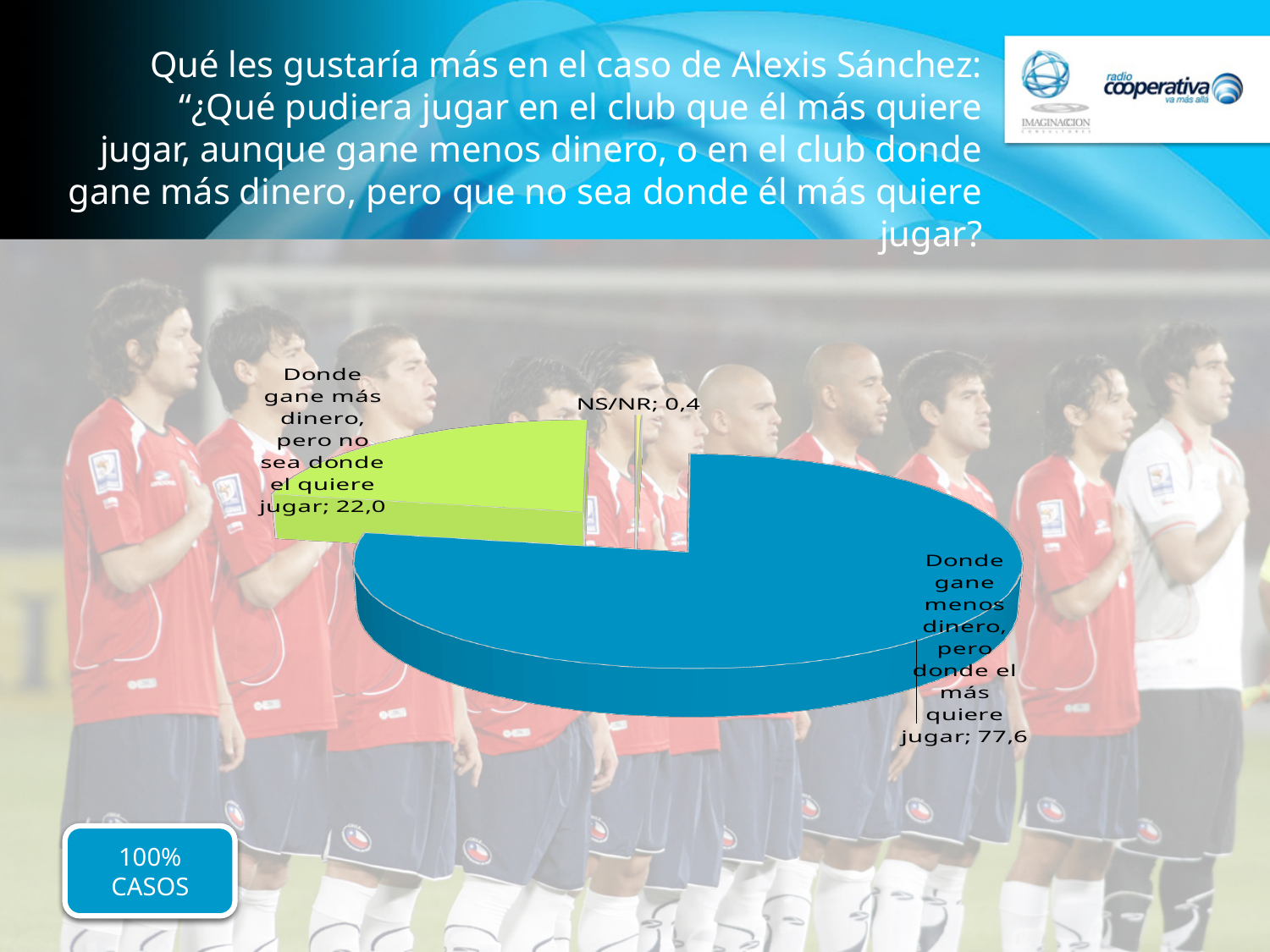
What colour is the slice for "Donde gane más dinero, pero no sea donde el quiere jugar"? green What is the combined value of the two named club options (excluding NS/NR)? 99,6 What kind of chart is shown on the slide? pie chart How many slices does the pie chart have? 3 Which slice of the pie chart is the smallest? NS/NR What is the difference between the value for "Donde gane menos dinero, pero donde el más quiere jugar" and the value for "Donde gane más dinero, pero no sea donde el quiere jugar"? 55,6 What is the value for "Donde gane más dinero, pero no sea donde el quiere jugar"? 22,0 What colour is the largest slice of the pie chart? blue Which slice of the pie chart is the largest? Donde gane menos dinero, pero donde el más quiere jugar Which is larger: the value for "Donde gane más dinero, pero no sea donde el quiere jugar" or the value for NS/NR? Donde gane más dinero, pero no sea donde el quiere jugar What is the value for "Donde gane menos dinero, pero donde el más quiere jugar"? 77,6 What is the value for NS/NR? 0,4